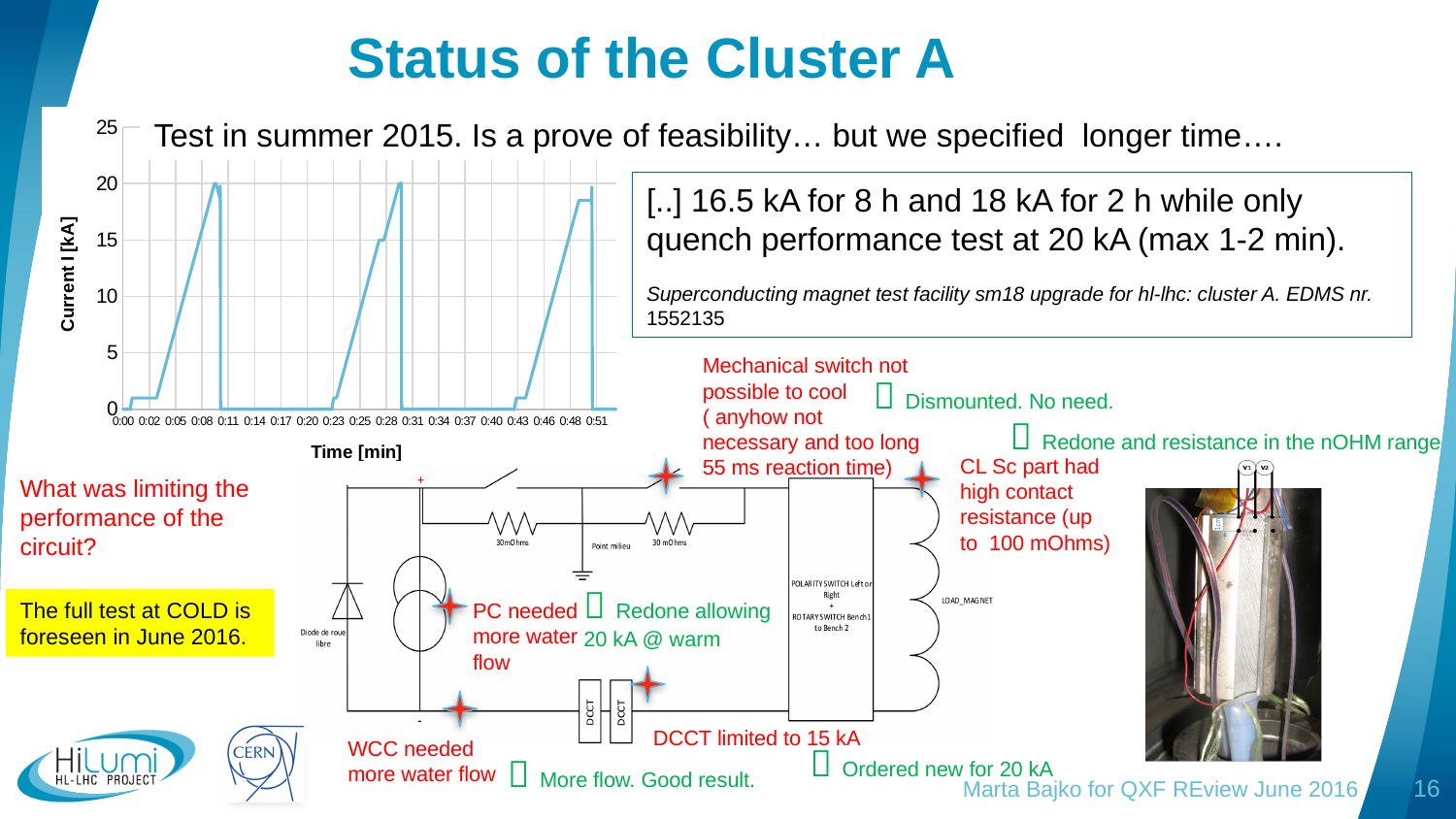
What kind of chart is shown on the left of the slide? line chart What is the label of the horizontal axis of the chart? Time [min] Is the peak value of the first current ramp greater or less than 15 kA? greater How many current ramps (peaks) are plotted on the chart? 3 What is the label of the vertical axis of the chart? Current I [kA] Does the current rise or fall between 0:05 and 0:08 on the chart? rise Is the peak value of the third current ramp greater or less than 15 kA? greater What is the highest tick value shown on the vertical axis of the chart? 25 Is the peak value of the second current ramp greater or less than 10 kA? greater